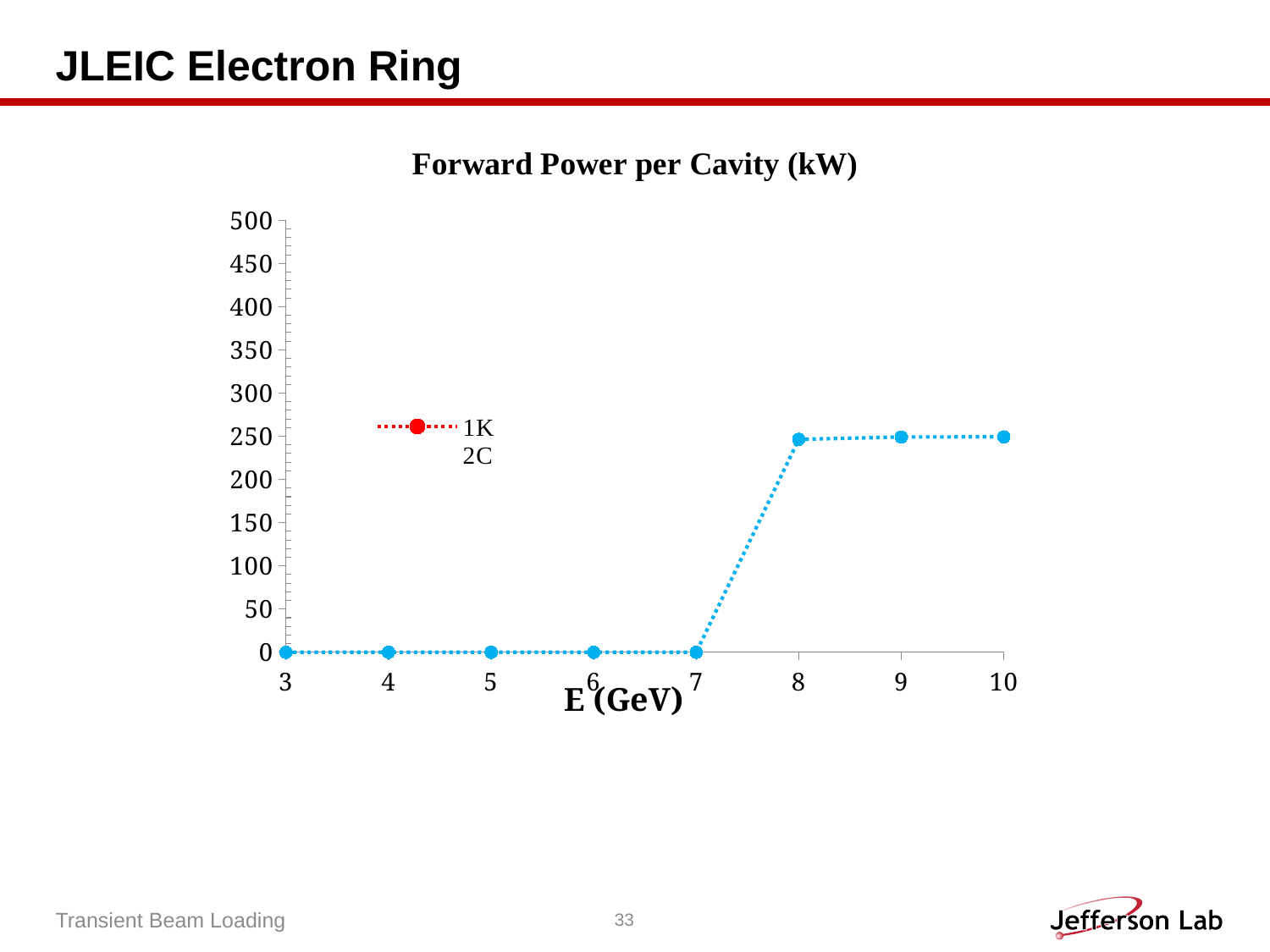
Is the value at E = 10 GeV greater or less than 300? less Do the plotted values rise or fall as E increases from 3 to 10 GeV? rise What is the forward power per cavity at E = 7 GeV? 0 Which has the larger forward power per cavity, E = 7 GeV or E = 8 GeV? 8 GeV Is the value at E = 8 GeV greater or less than 200? greater What kind of chart is shown on the slide? line chart How many data points are plotted on the blue line? 8 What is the forward power per cavity at E = 3 GeV? 0 What is the title of the chart? Forward Power per Cavity (kW) What is the label of the x axis? E (GeV) Between which two x-axis values does the forward power jump sharply? 7 and 8